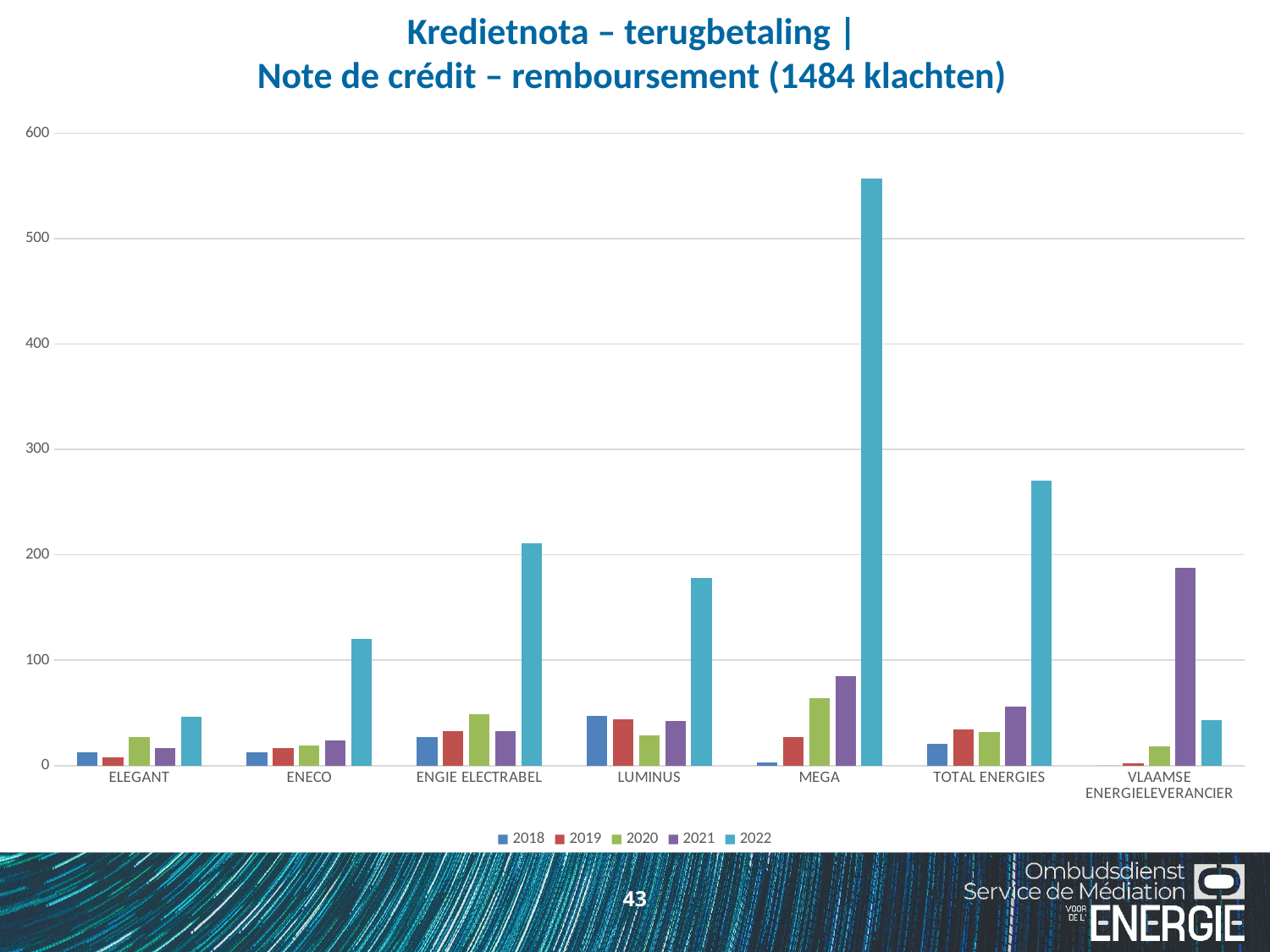
What is the title of the chart? Kredietnota – terugbetaling | Note de crédit – remboursement (1484 klachten) Which year has the lowest bar for MEGA? 2018 How many series does the legend list? 5 How many suppliers (categories) are shown on the x axis? 7 Is the 2022 value for TOTAL ENERGIES greater or less than 200? greater Is the 2022 value for ENECO greater or less than 100? greater Which supplier has the highest bar for 2022? MEGA Is the 2022 value for MEGA greater or less than 500? greater What kind of chart is shown on the slide? bar chart Which year has the highest bar for VLAAMSE ENERGIELEVERANCIER? 2021 Which is larger: the 2022 value for TOTAL ENERGIES or the 2022 value for ENGIE ELECTRABEL? TOTAL ENERGIES